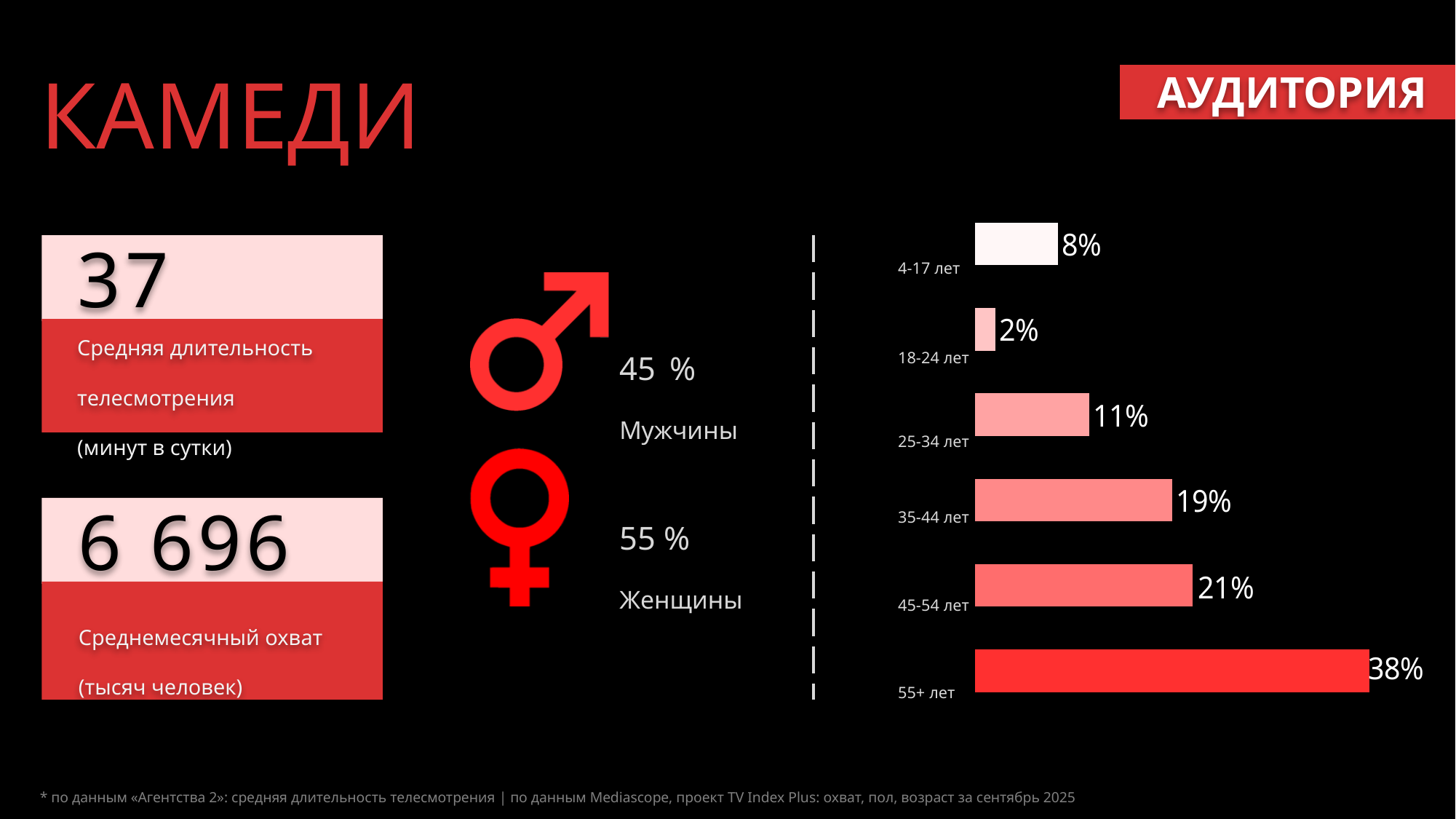
What kind of chart is used to show the age groups on the slide? Bar chart What is the difference between the values for 25-34 лет and 4-17 лет in the bar chart? 3% What is the value for the 4-17 лет age group in the bar chart? 8% Do the values in the bar chart rise or fall from the 18-24 лет group down to the 55+ лет group? Rise What is the value for the 35-44 лет age group in the bar chart? 19% Which is larger in the bar chart: the value for 45-54 лет or the value for 35-44 лет? 45-54 лет Which age group has the lowest value in the bar chart? 18-24 лет How many age groups are shown in the bar chart? 6 What is the difference between the values for 55+ лет and 45-54 лет in the bar chart? 17% What is the value for the 18-24 лет age group in the bar chart? 2% What is the value for the 55+ лет age group in the bar chart? 38% Which age group has the highest value in the bar chart? 55+ лет